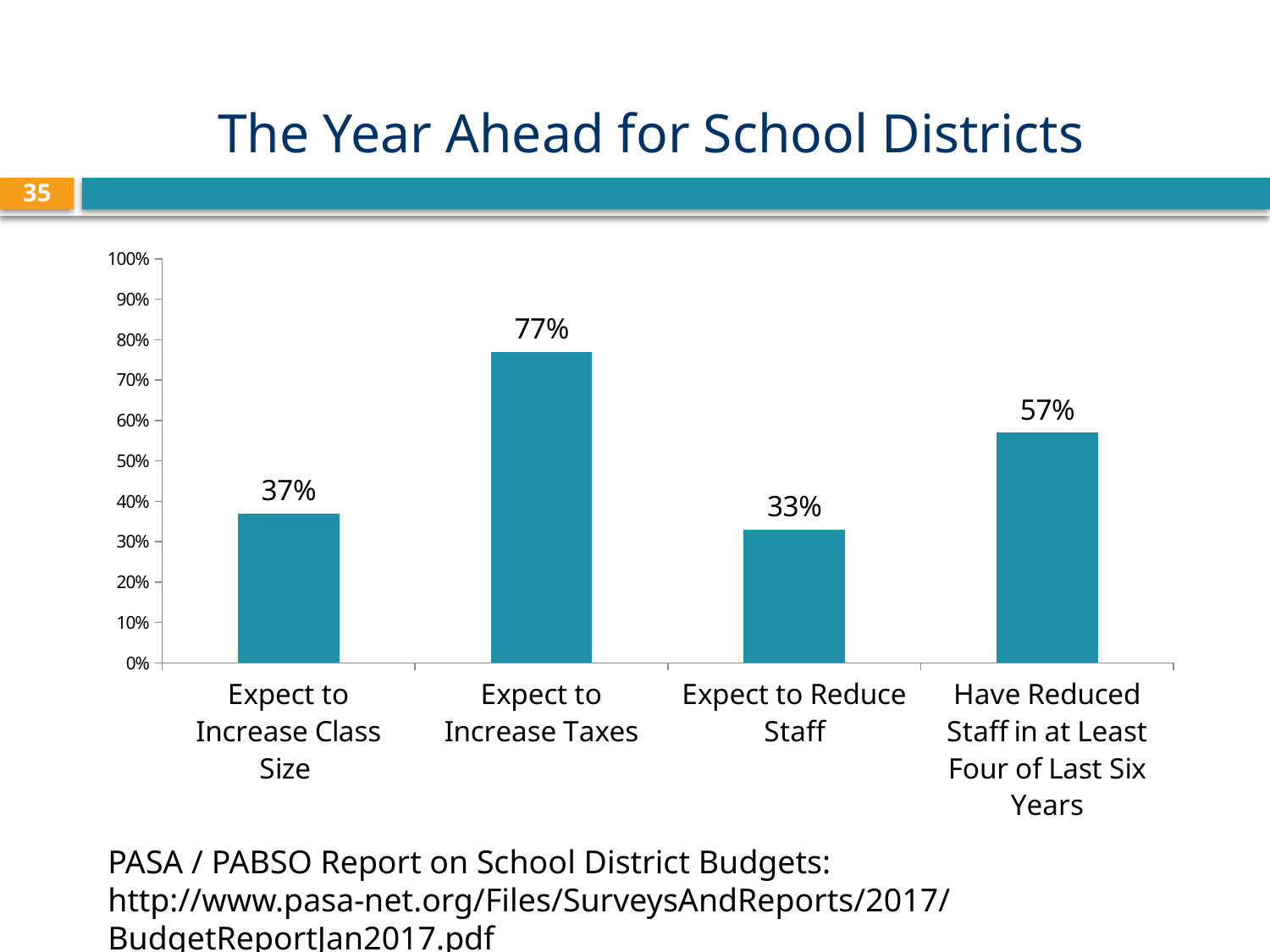
What percentage of school districts expect to reduce staff? 33% What kind of chart is shown on the slide? Bar chart What percentage of school districts expect to increase class size? 37% What is the difference between the percentage that expect to increase taxes and the percentage that expect to reduce staff? 44% Which category has the highest value? Expect to Increase Taxes What is the title of the slide? The Year Ahead for School Districts How many categories are shown in the chart? 4 Which is larger: the value for Expect to Increase Class Size or the value for Expect to Reduce Staff? Expect to Increase Class Size What is the difference between the percentage that have reduced staff in at least four of the last six years and the percentage that expect to increase class size? 20% What percentage of school districts expect to increase taxes? 77% Which category has the lowest value? Expect to Reduce Staff What percentage of school districts have reduced staff in at least four of the last six years? 57%